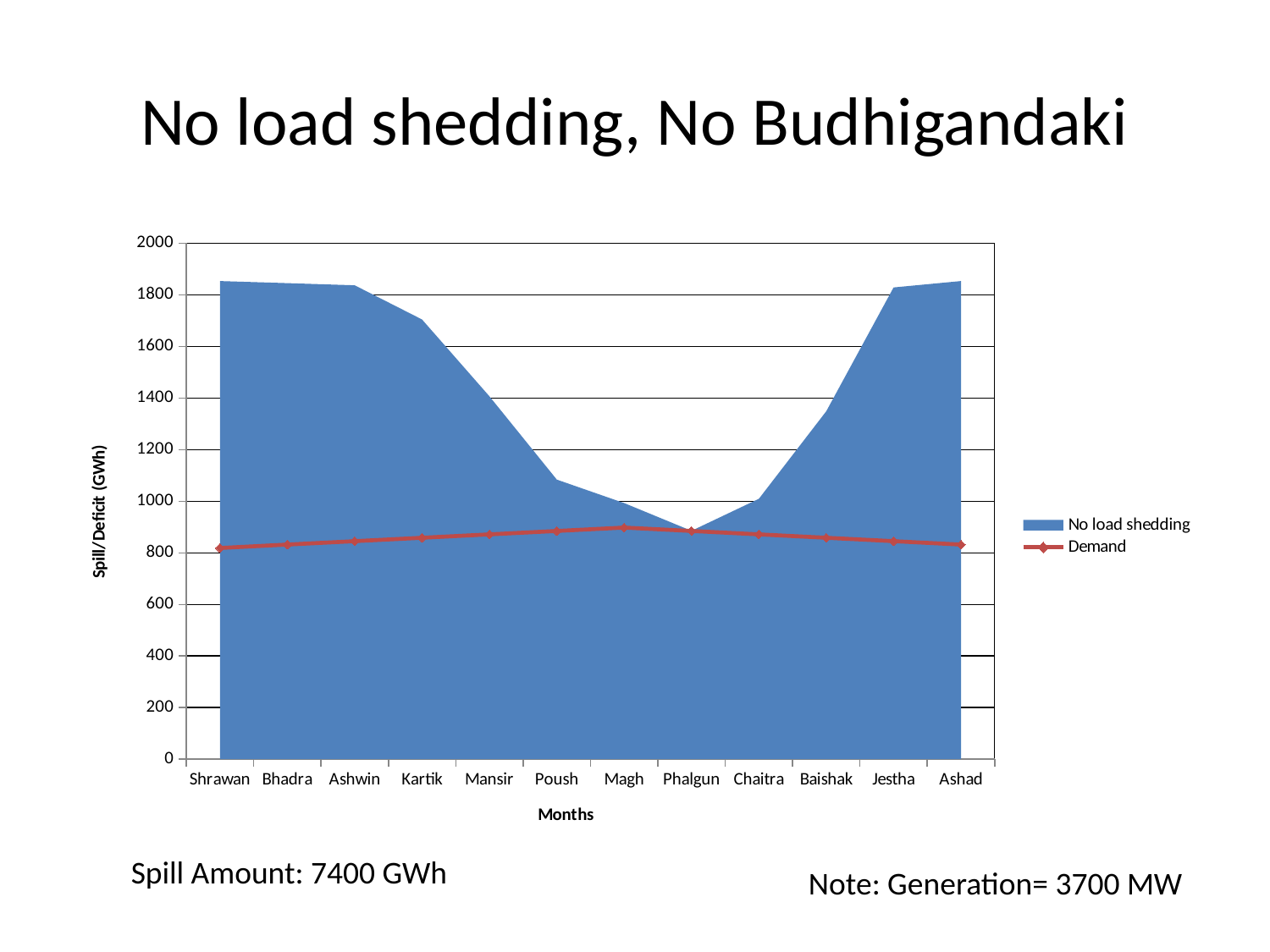
Is the No load shedding value for Phalgun greater or less than 1000? less What are the two series named in the chart legend? No load shedding and Demand Is the No load shedding value for Baishak greater or less than 1200? greater How many series does the chart legend list? 2 Does the No load shedding series rise or fall from Shrawan to Phalgun? fall Which month has the lowest value for the No load shedding series? Phalgun Is the No load shedding value for Shrawan greater or less than 1800? greater What is the title of the chart's vertical axis? Spill/Deficit (GWh) Which is larger, the No load shedding value for Kartik or for Phalgun? Kartik How many months are shown on the x axis of the chart? 12